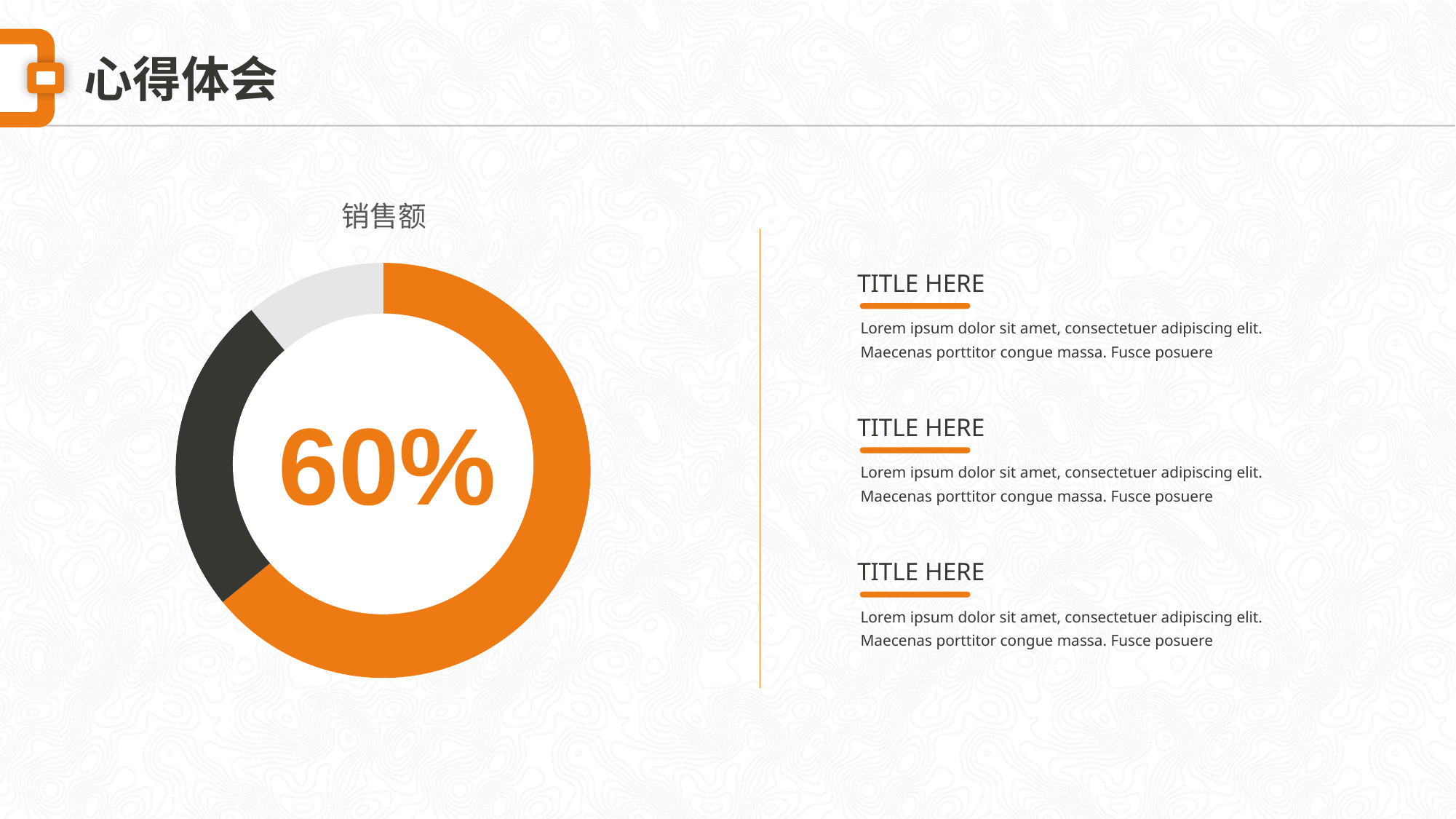
What percentage is printed in the centre of the doughnut chart? 60% Which is larger, the orange slice or the dark grey slice? The orange slice What colour is the largest slice of the doughnut chart? Orange Is the share of the dark grey slice greater or less than 50%? less Which is larger, the dark grey slice or the light grey slice? The dark grey slice What is the title of the chart? 销售额 Which slice of the doughnut chart is the largest? The orange slice Is the share of the orange slice greater or less than 50%? greater Which slice of the doughnut chart is the smallest? The light grey slice How many slices does the doughnut chart have? 3 What kind of chart is shown on the slide? Doughnut (pie) chart